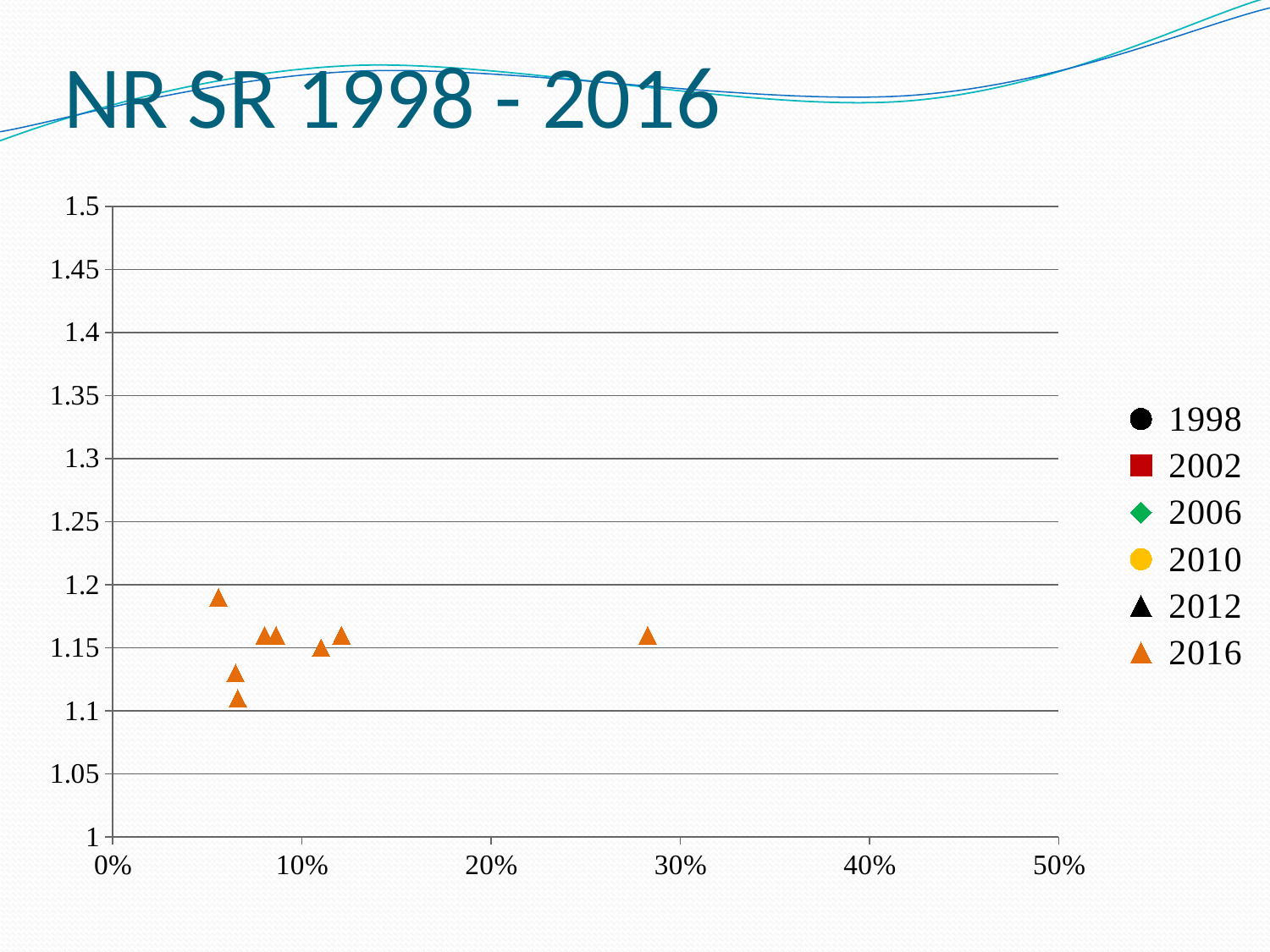
What is the maximum value shown on the x axis? 50% Is the x value of the rightmost 2016 point greater or less than 20%? greater Which series is plotted with orange triangles? 2016 Is the y value of the lowest 2016 point greater or less than 1.05? greater Is the leftmost 2016 point higher or lower on the y axis than the rightmost 2016 point? higher Is the y value of the rightmost 2016 point (near 28% on the x axis) greater or less than 1.25? less What is the title of the chart? NR SR 1998 - 2016 How many series does the legend list? 6 How many 2016 points are plotted on the chart? 8 What kind of chart is shown on the slide? scatter chart Which series is the only one with points visible on the chart? 2016